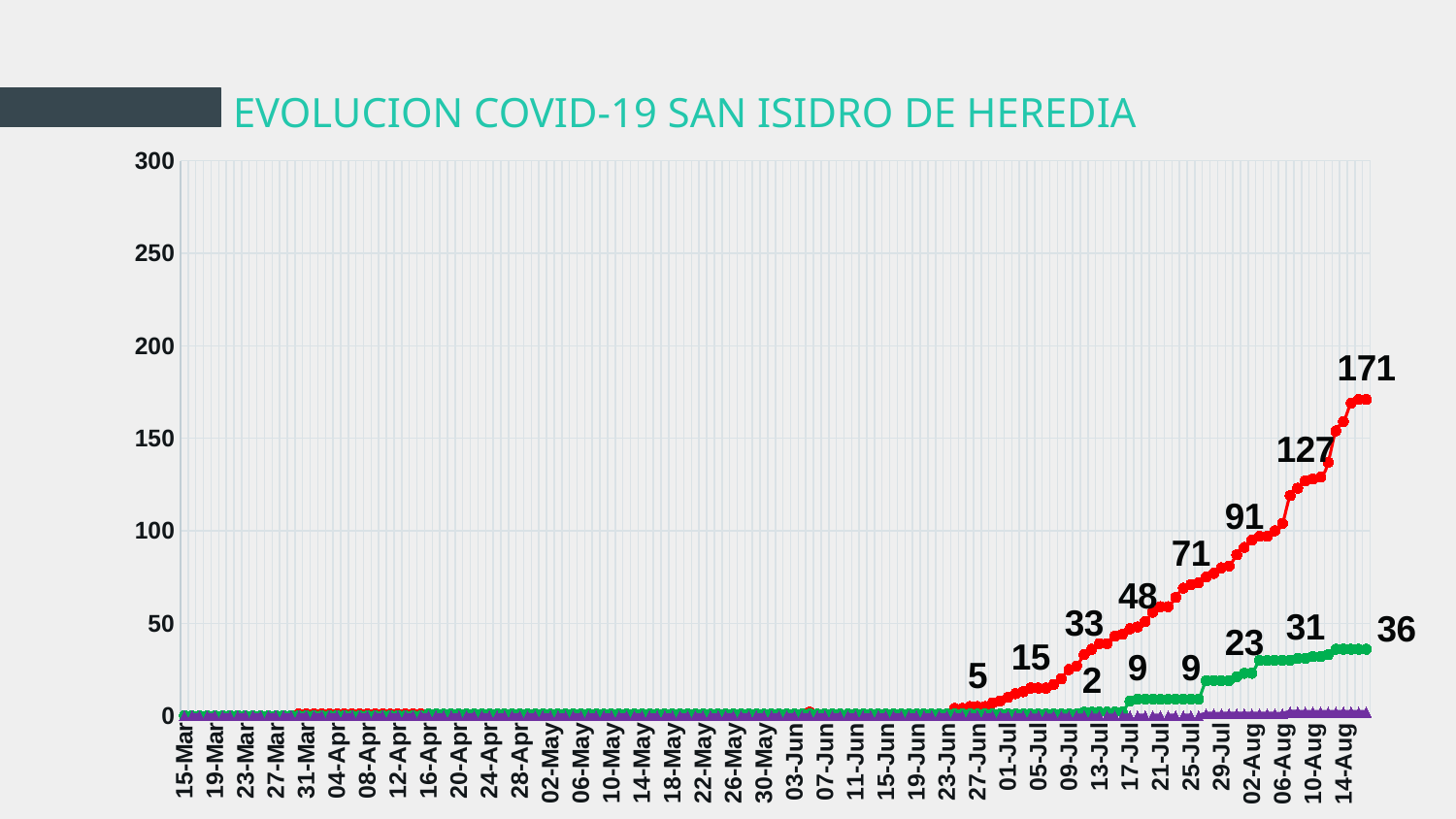
Is the value of the red line at the right end of the chart greater or less than 150? greater At the right end of the chart, which line has the larger value, the red line or the green line? red line What kind of chart is shown on the slide? line chart What is the last labelled value of the green line at the right end of the chart? 36 Is the value of the green line at the right end of the chart greater or less than 50? less What is the difference between the last two labelled values on the red line, 171 and 127? 44 How many data labels are printed along the red line? 8 What is the difference between the final labelled values of the red line (171) and the green line (36)? 135 What is the title of the chart? EVOLUCION COVID-19 SAN ISIDRO DE HEREDIA What is the highest labelled value on the red line? 171 What is the last labelled value of the red line at the right end of the chart? 171 Does the red line rise or fall from July to August along the x axis? rise